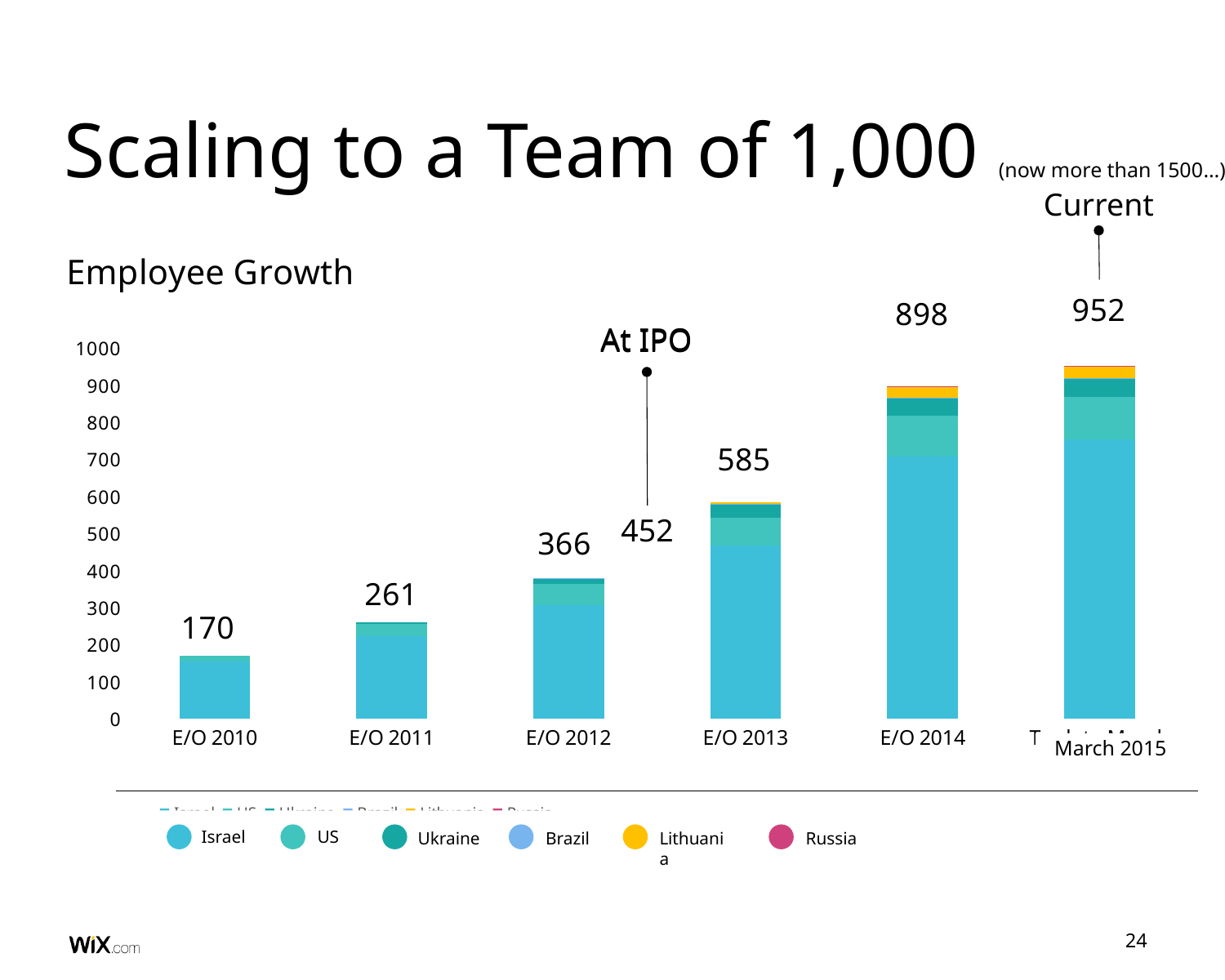
What is the difference between the totals for E/O 2014 and E/O 2013? 313 What is the total employee count shown for March 2015? 952 Which period has the highest total employee count? March 2015 What is the total employee count shown for E/O 2010? 170 Which is larger, the total for E/O 2012 or the total for E/O 2011? E/O 2012 Which period has the lowest total employee count? E/O 2010 How many series does the legend list? 6 What is the total employee count shown for E/O 2014? 898 Is the Israel segment of the E/O 2014 bar greater or less than 600? greater Do the total employee counts rise or fall from E/O 2010 to March 2015? Rise What kind of chart is shown on the slide? Stacked bar chart How many periods are shown on the x axis? 6